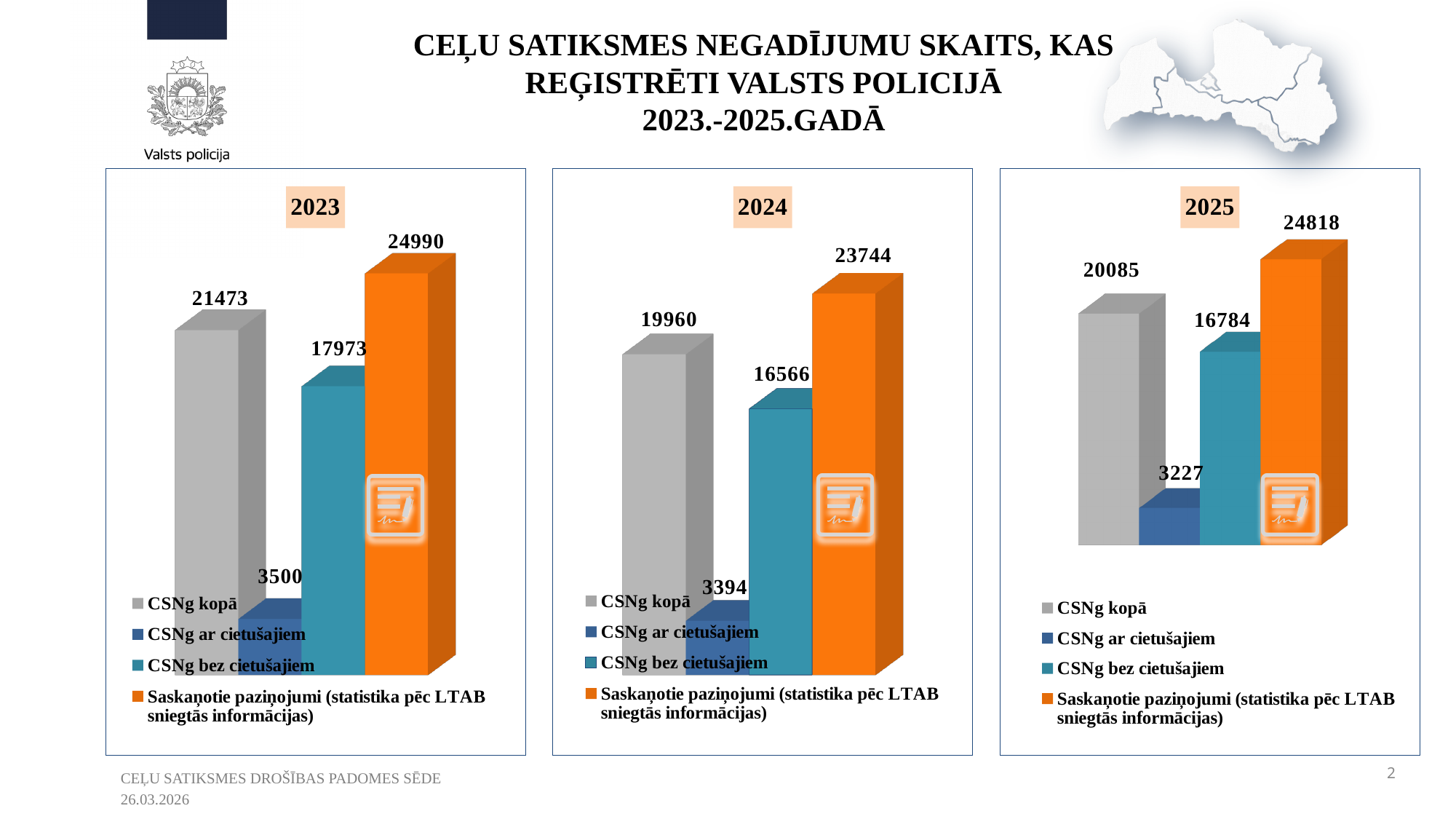
In the 2025 chart, what is the value for Saskaņotie paziņojumi (statistika pēc LTAB sniegtās informācijas)? 24818 In the 2024 chart, what is the value for CSNg ar cietušajiem? 3394 How many series does the legend of the 2025 chart list? 4 In the 2023 chart, what is the value for CSNg kopā? 21473 In the 2024 chart, which is larger: CSNg kopā or Saskaņotie paziņojumi? Saskaņotie paziņojumi In the 2024 chart, which series has the lowest value? CSNg ar cietušajiem How many charts are shown on the slide? 3 In the 2025 chart, what is the difference between Saskaņotie paziņojumi and CSNg kopā? 4733 In the 2025 chart, what is the value for CSNg bez cietušajiem? 16784 In the 2023 chart, what is the difference between CSNg kopā and CSNg bez cietušajiem? 3500 In the 2023 chart, which series has the highest value? Saskaņotie paziņojumi (statistika pēc LTAB sniegtās informācijas) What type of chart is the 2024 chart? bar chart